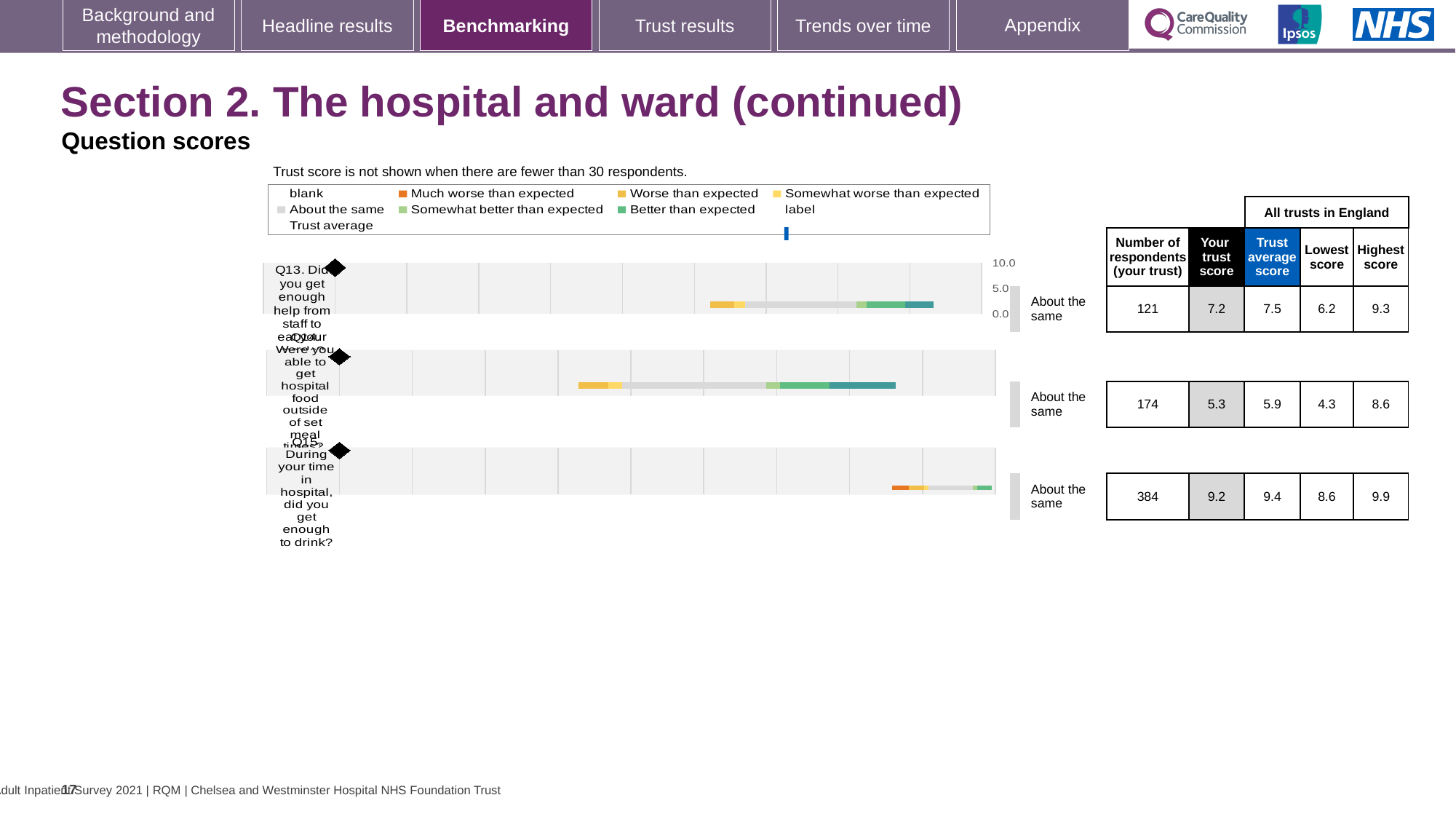
For Q14, which is larger: 'Your trust score' or the trust average score? Trust average score How many respondents from the trust answered Q14 (Were you able to get hospital food outside of set meal times?)? 174 What is the trust average score across all trusts in England for Q15 (did you get enough to drink?)? 9.4 What is the highest score among all trusts in England for Q14? 8.6 Which question has the highest 'Your trust score'? Q15 What benchmark rating is shown next to the bar for Q13? About the same How many questions are plotted in the chart? 3 For Q13, how much higher is the trust average score than 'Your trust score'? 0.3 What kind of chart is used to show the question scores for Q13, Q14 and Q15? bar chart What is the 'Your trust score' for Q13 (Did you get enough help from staff to eat your meals?)? 7.2 Which question has the lowest 'Your trust score'? Q14 For Q15, what is the difference between the highest score and the lowest score among all trusts in England? 1.3